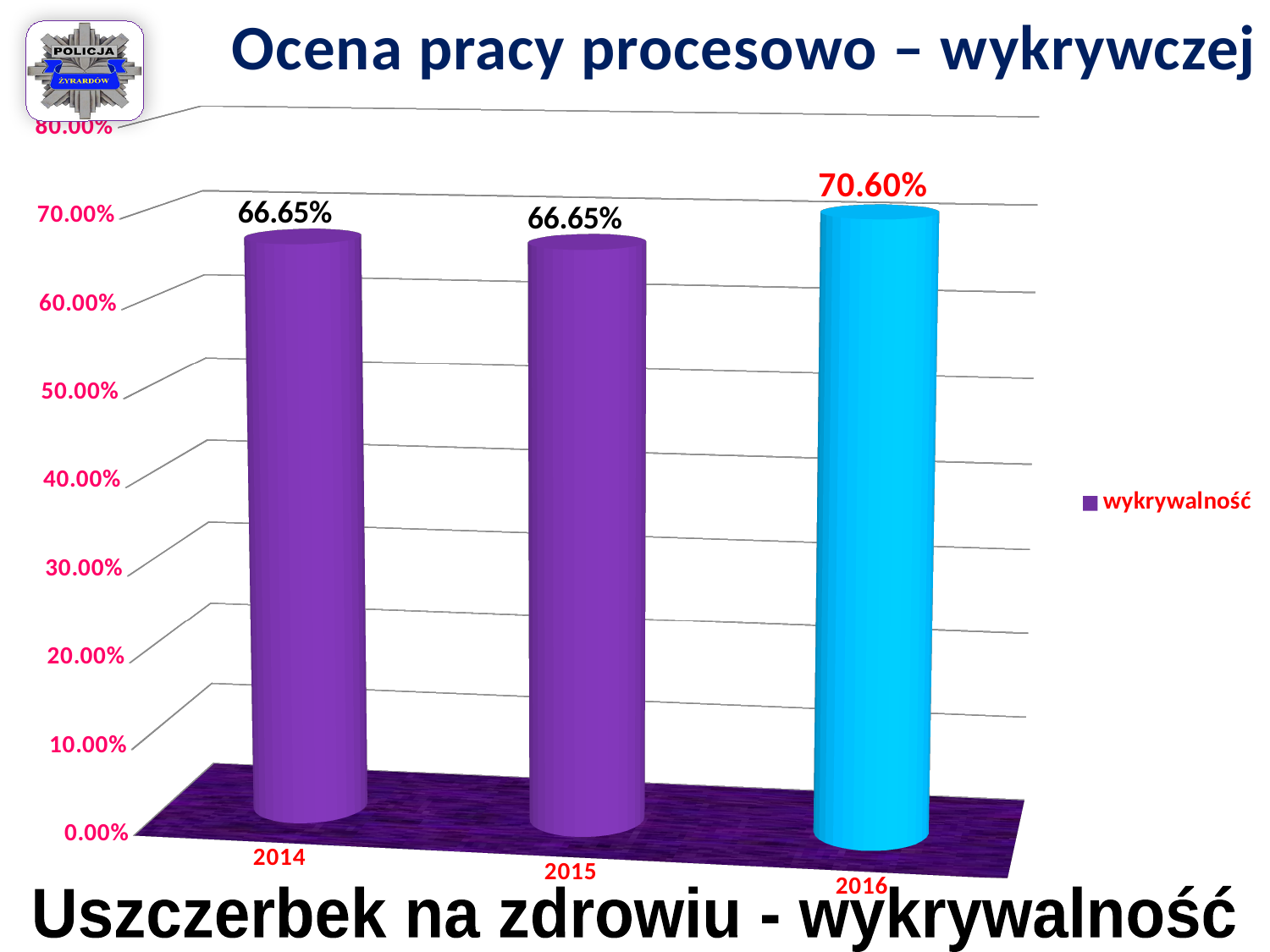
How many years are shown on the x axis? 3 Which year has the highest value? 2016 Is the value for 2016 greater or less than 70.00%? greater What is the legend entry for the series? wykrywalność Which is larger, the value for 2014 or the value for 2016? 2016 Is the value for 2014 greater or less than 70.00%? less What is the value for 2014? 66.65% What is the value for 2016? 70.60% How many series does the legend list? 1 What kind of chart is shown? bar chart What is the value for 2015? 66.65% What is the difference between the values for 2016 and 2015? 3.95%